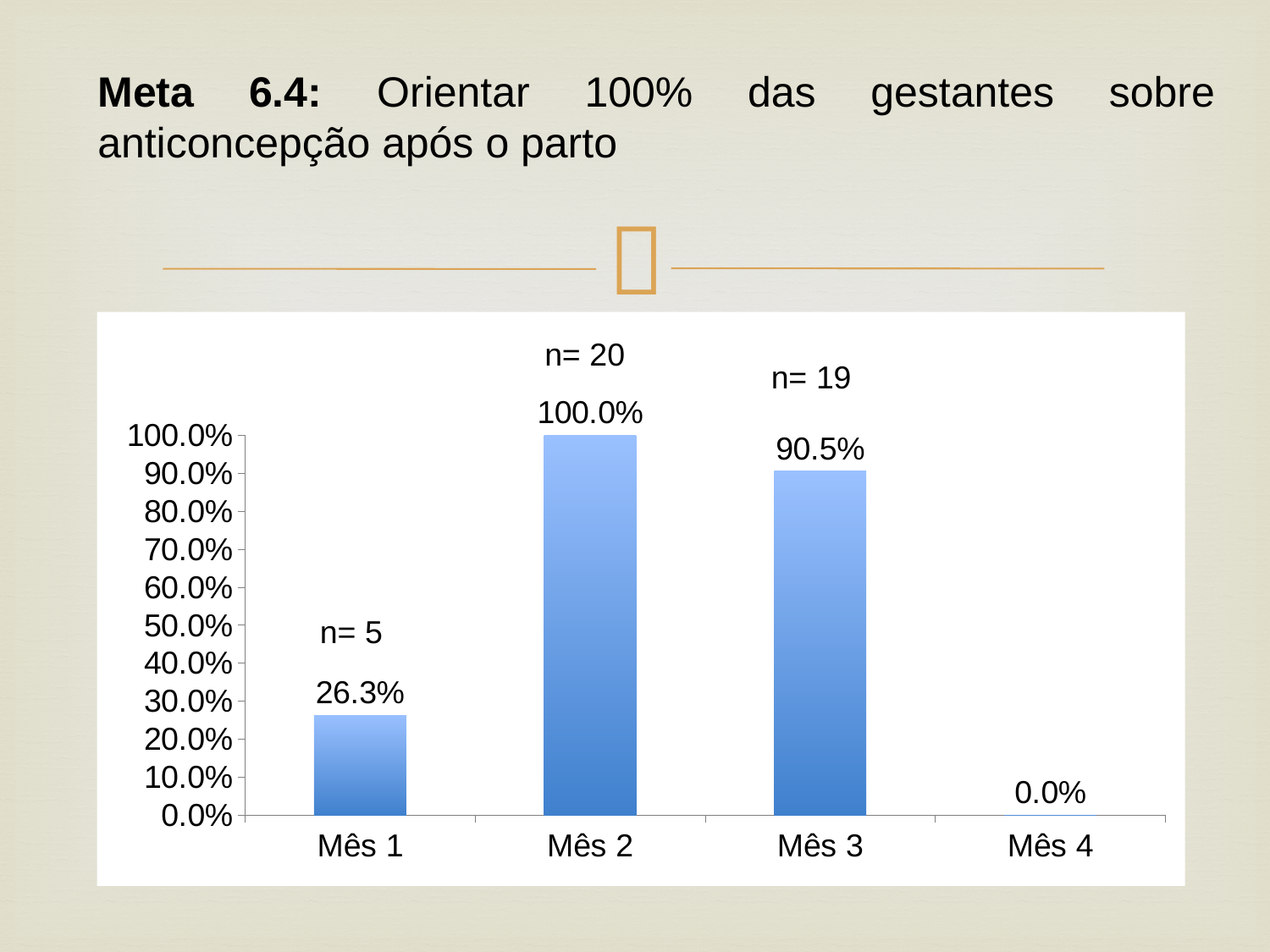
What is the n value annotated above the bar for Mês 3? n= 19 What is the difference between the values for Mês 3 and Mês 1? 64.2% What is the difference between the values for Mês 2 and Mês 3? 9.5% What is the value for Mês 4? 0.0% What kind of chart is shown on the slide? Bar chart How many categories are shown on the x axis? 4 What is the value for Mês 1? 26.3% What is the value for Mês 2? 100.0% What is the value for Mês 3? 90.5% Which month has the lowest value? Mês 4 Which is larger, the value for Mês 1 or the value for Mês 3? Mês 3 Which month has the highest value? Mês 2